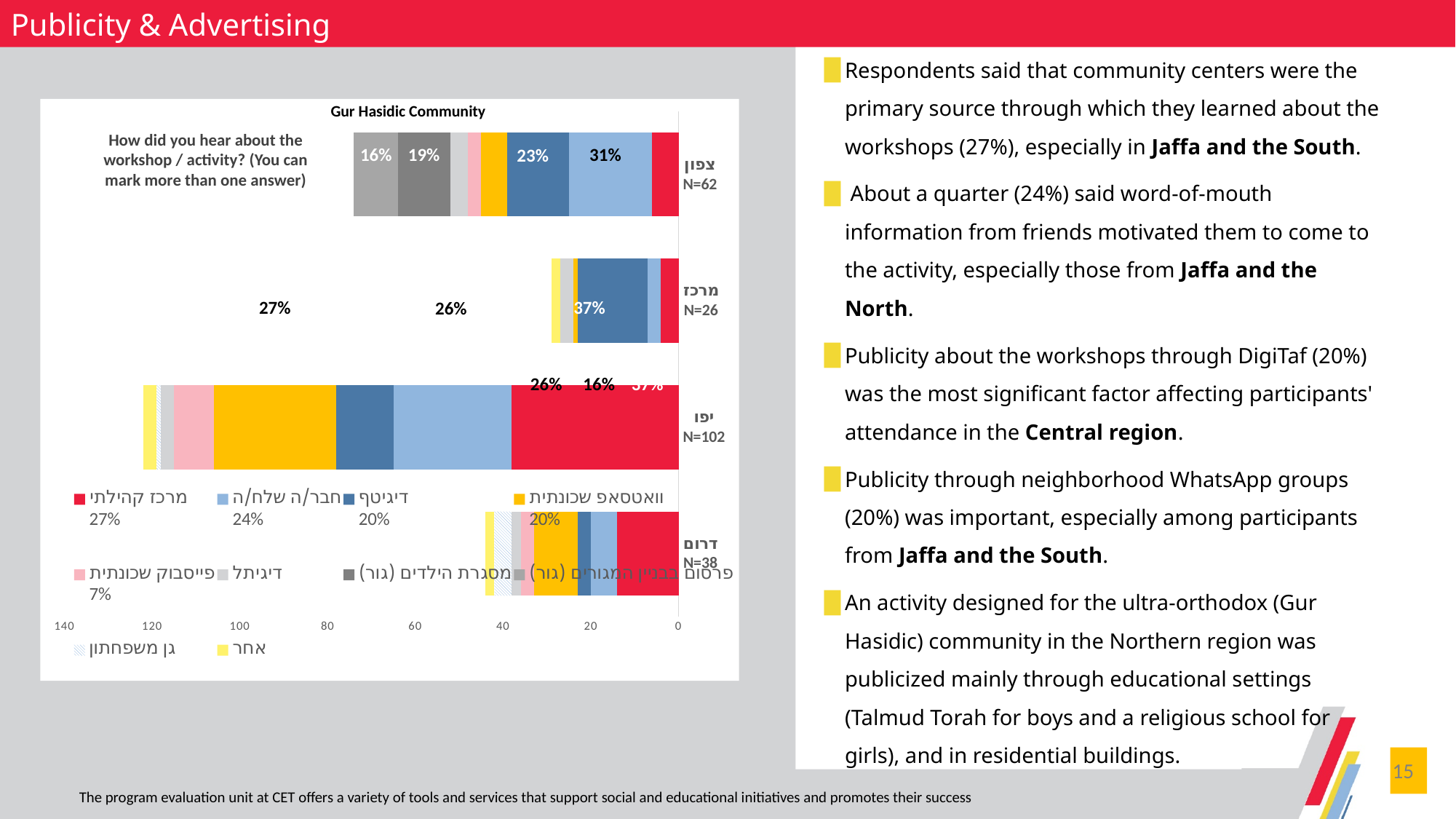
How many entries does the chart legend list? 10 What is the N value shown for the צפון (North) bar? N=62 Is the total length of the מרכז (Center) bar greater or less than 40? less Which region has the shortest stacked bar? מרכז (Center) Which region has the longest stacked bar? יפו (Jaffa) How many regions (bars) are plotted in the chart? 4 Is the total length of the יפו (Jaffa) bar greater or less than 100? greater What is the N value shown for the מרכז (Center) bar? N=26 What kind of chart is shown on the slide? Stacked bar chart What percentage is labelled on the דיגיטף (dark blue) segment of the מרכז (Center) bar? 37% What percentage is shown next to מרכז קהילתי in the legend? 27% What is the N value shown for the יפו (Jaffa) bar? N=102